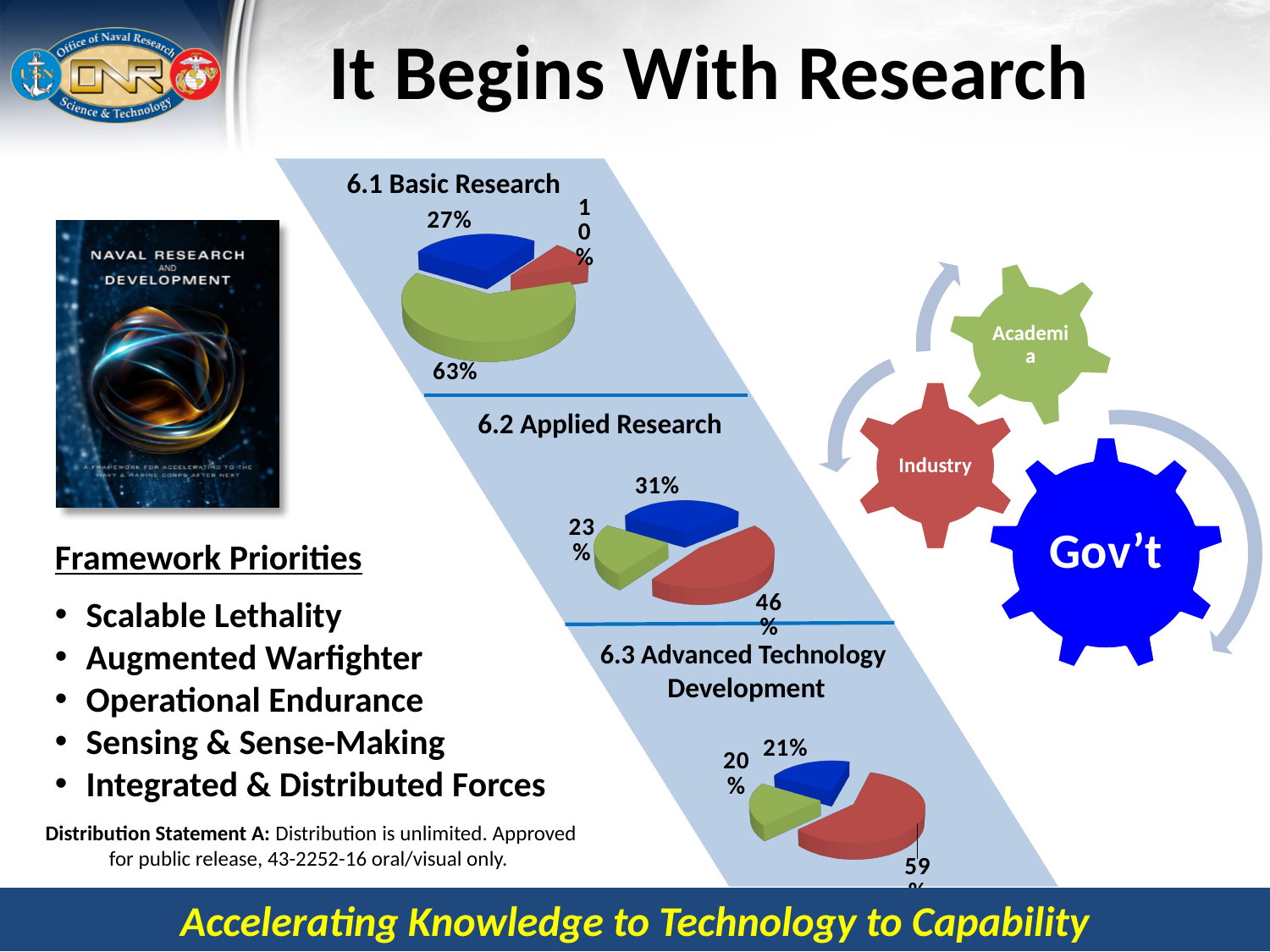
In the 6.1 Basic Research chart, what percentage does the green slice represent? 63% In the 6.3 Advanced Technology Development chart, what percentage does the green slice represent? 20% In the 6.2 Applied Research chart, what percentage does the red slice represent? 46% In the 6.1 Basic Research chart, what percentage does the blue slice represent? 27% How many pie charts are shown on the slide? 3 In the 6.1 Basic Research chart, which slice is the smallest? The red slice (10%) What type of chart is used for 6.2 Applied Research? Pie chart In the 6.2 Applied Research chart, what is the difference between the blue slice and the green slice? 8% In the 6.3 Advanced Technology Development chart, what percentage does the red slice represent? 59% In the 6.3 Advanced Technology Development chart, is the blue slice or the red slice larger? The red slice How many slices does the 6.1 Basic Research chart have? 3 In the 6.2 Applied Research chart, which slice is the largest? The red slice (46%)